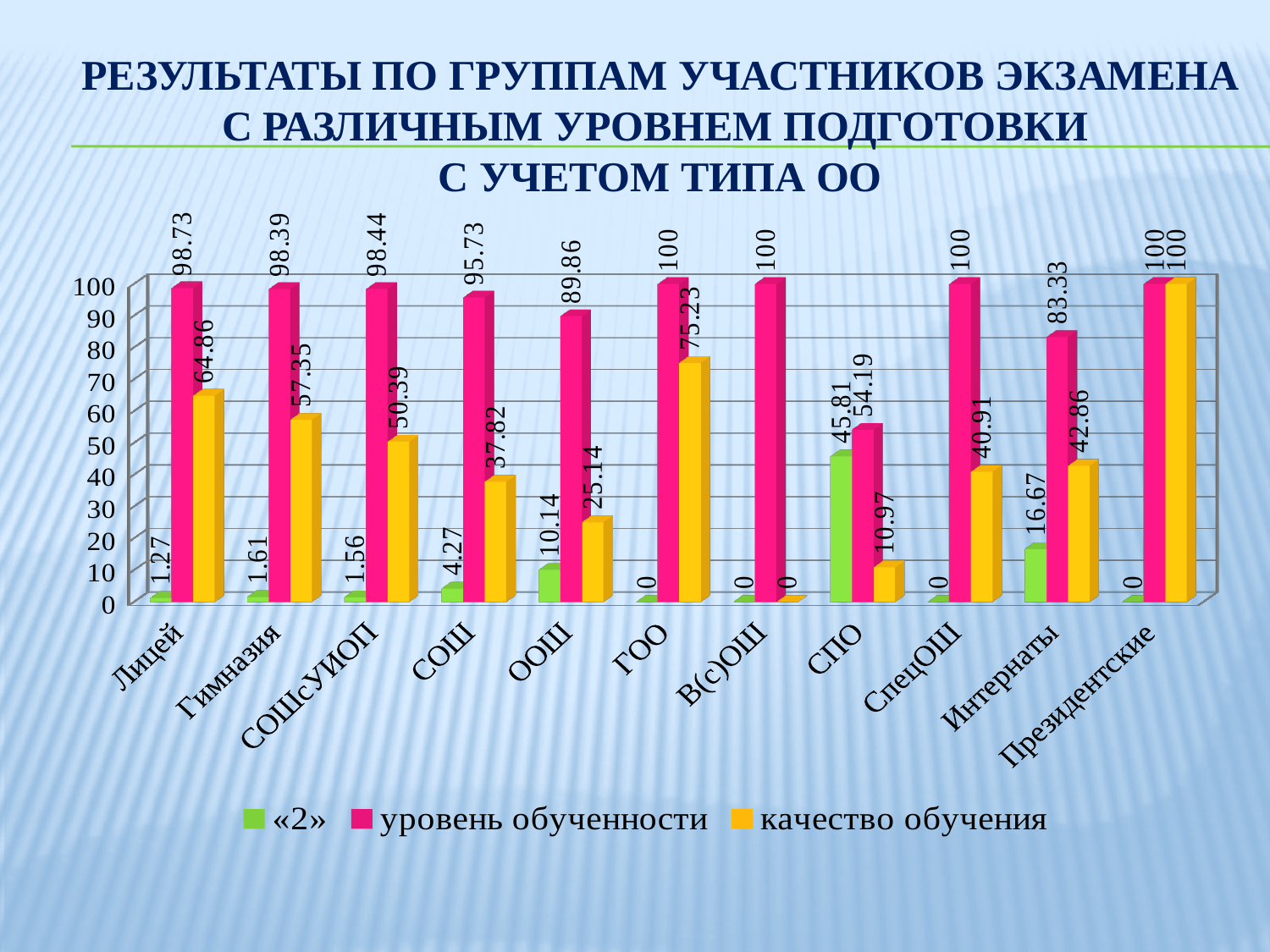
Which category has the lowest value of «уровень обученности»? СПО What is the value of «уровень обученности» for Лицей? 98.73 What is the value of «качество обучения» for ГОО? 75.23 How many series does the legend list? 3 What is the difference between «качество обучения» for Лицей and for Гимназия? 7.51 Which is larger: «качество обучения» for СпецОШ or for Интернаты? Интернаты What kind of chart is shown on the slide? bar chart What is the value of «качество обучения» for Интернаты? 42.86 How many categories are shown on the x axis? 11 Which category has the highest value in the «2» series? СПО Which colour represents the «качество обучения» series? yellow What is the value of the «2» series for СПО? 45.81